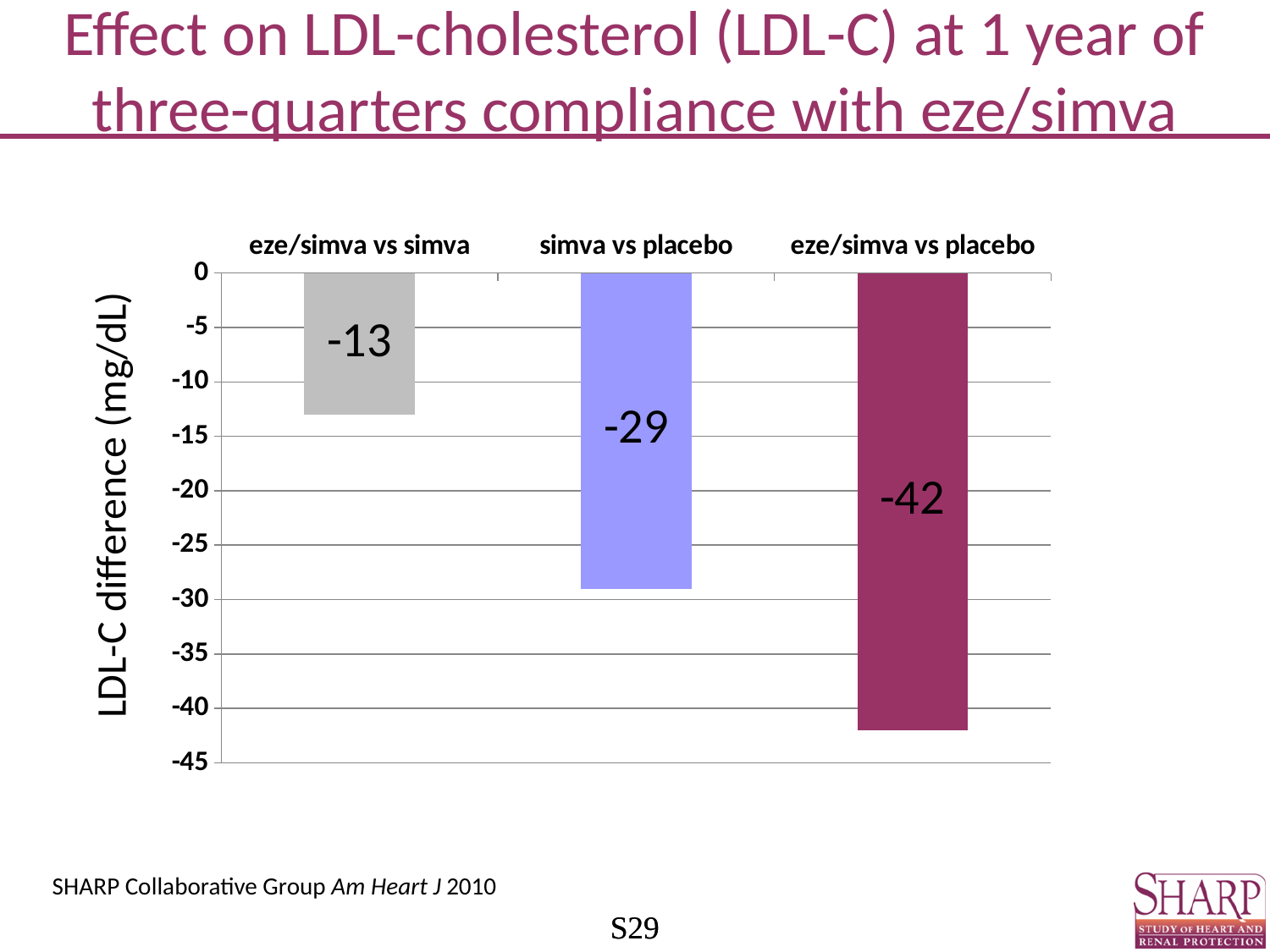
Which has a larger LDL-C reduction, simva vs placebo or eze/simva vs simva? simva vs placebo What colour is the bar for eze/simva vs placebo? purple How many comparison bars are shown in the chart? 3 What is the difference between the LDL-C values for simva vs placebo and eze/simva vs simva? 16 What is the LDL-C difference for eze/simva vs simva? -13 What is the LDL-C difference for simva vs placebo? -29 Which comparison shows the largest LDL-C reduction? eze/simva vs placebo What is the LDL-C difference for eze/simva vs placebo? -42 Which comparison shows the smallest LDL-C reduction? eze/simva vs simva What is the label of the vertical axis? LDL-C difference (mg/dL) What kind of chart is shown on the slide? bar chart What is the difference between the LDL-C values for eze/simva vs placebo and simva vs placebo? 13